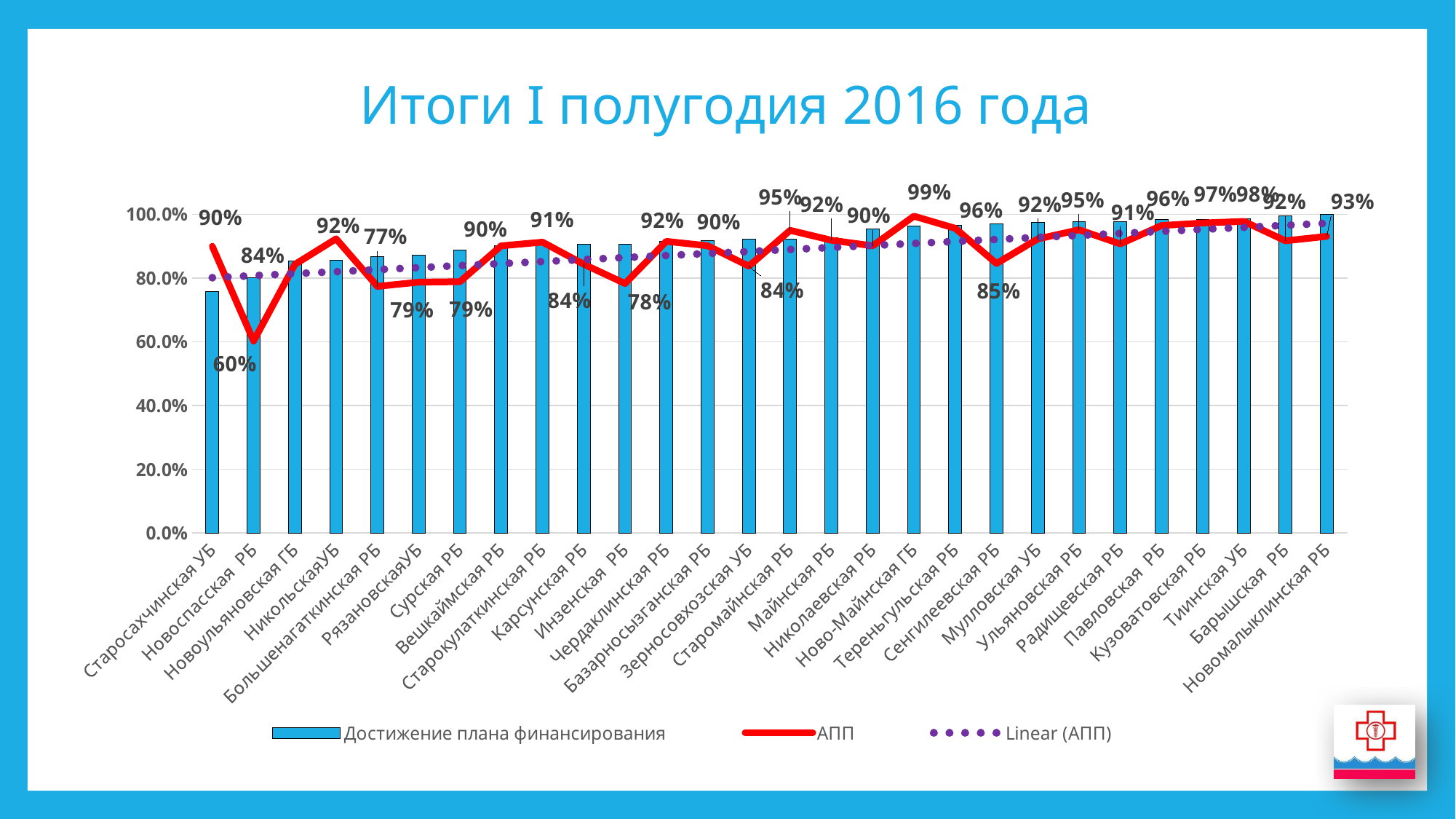
Which category has the highest АПП value? Ново-Майнская ГБ What is the АПП value for Большенагаткинская РБ? 77% What is the АПП value for Новоспасская РБ? 60% What is the title of the slide? Итоги I полугодия 2016 года What is the АПП value for Ново-Майнская ГБ? 99% Is the Достижение плана финансирования bar for Старосахчинская УБ greater or less than 80.0%? less What is the difference between the highest АПП value (Ново-Майнская ГБ) and the lowest (Новоспасская РБ)? 39 percentage points Which has a larger АПП value, Никольская УБ or Инзенская РБ? Никольская УБ How many series does the legend list? 3 How many categories are shown on the x axis? 28 Which category has the lowest АПП value? Новоспасская РБ What kind of chart is shown on the slide? Combined bar and line chart